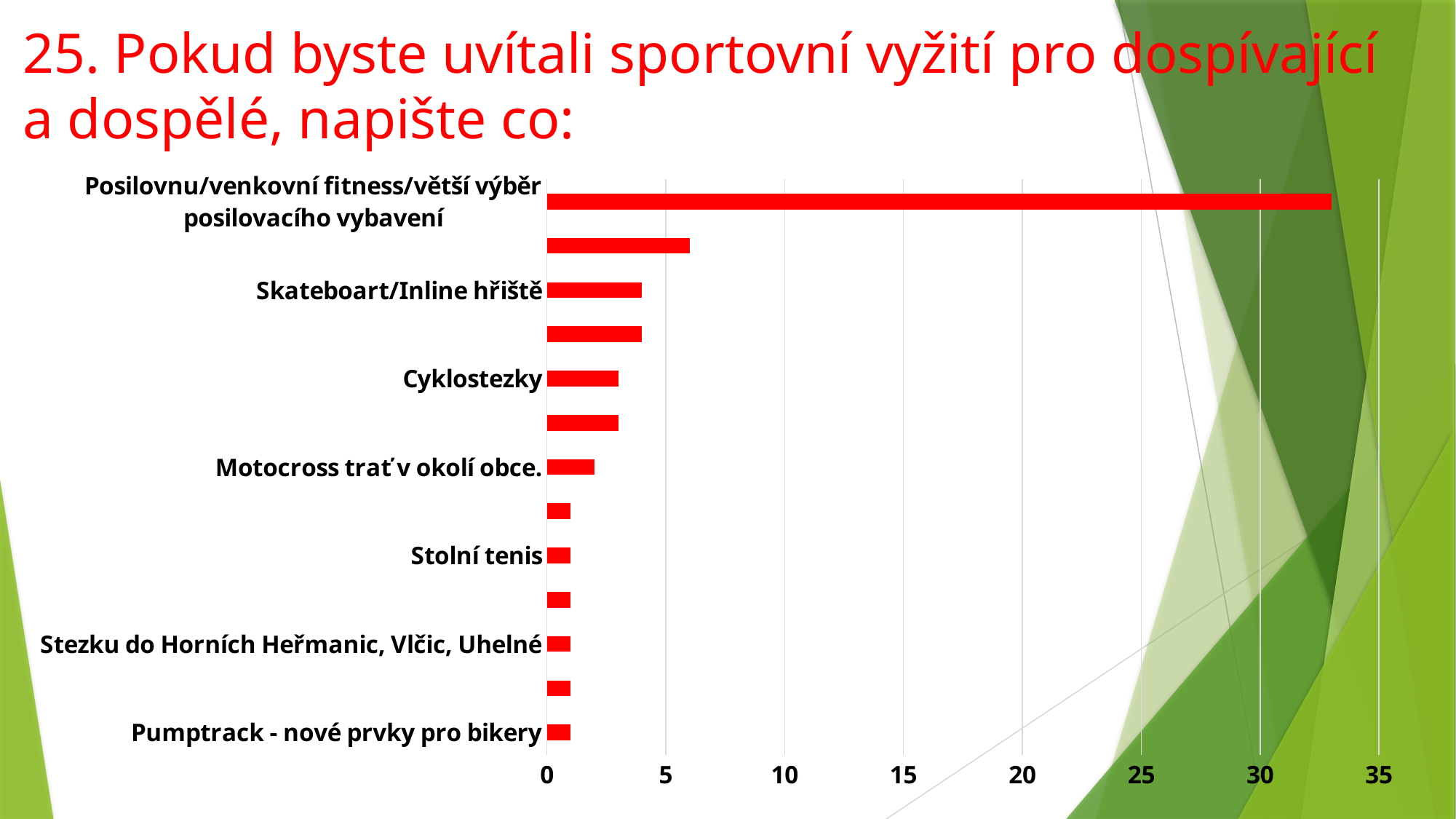
How many bars are plotted in the chart? 13 Which is larger, the value for Posilovnu/venkovní fitness/větší výběr posilovacího vybavení or the value for Skateboart/Inline hřiště? Posilovnu/venkovní fitness/větší výběr posilovacího vybavení Is the value for Skateboart/Inline hřiště greater or less than 5? less Is the value for Posilovnu/venkovní fitness/větší výběr posilovacího vybavení greater or less than 30? greater What is the highest value shown on the horizontal axis? 35 What colour are the bars in the chart? red What kind of chart is shown on the slide? bar chart Which is larger, the value for Cyklostezky or the value for Motocross trať v okolí obce.? Cyklostezky Is the value for Cyklostezky greater or less than 5? less Which is larger, the value for Skateboart/Inline hřiště or the value for Cyklostezky? Skateboart/Inline hřiště Which category has the highest value? Posilovnu/venkovní fitness/větší výběr posilovacího vybavení